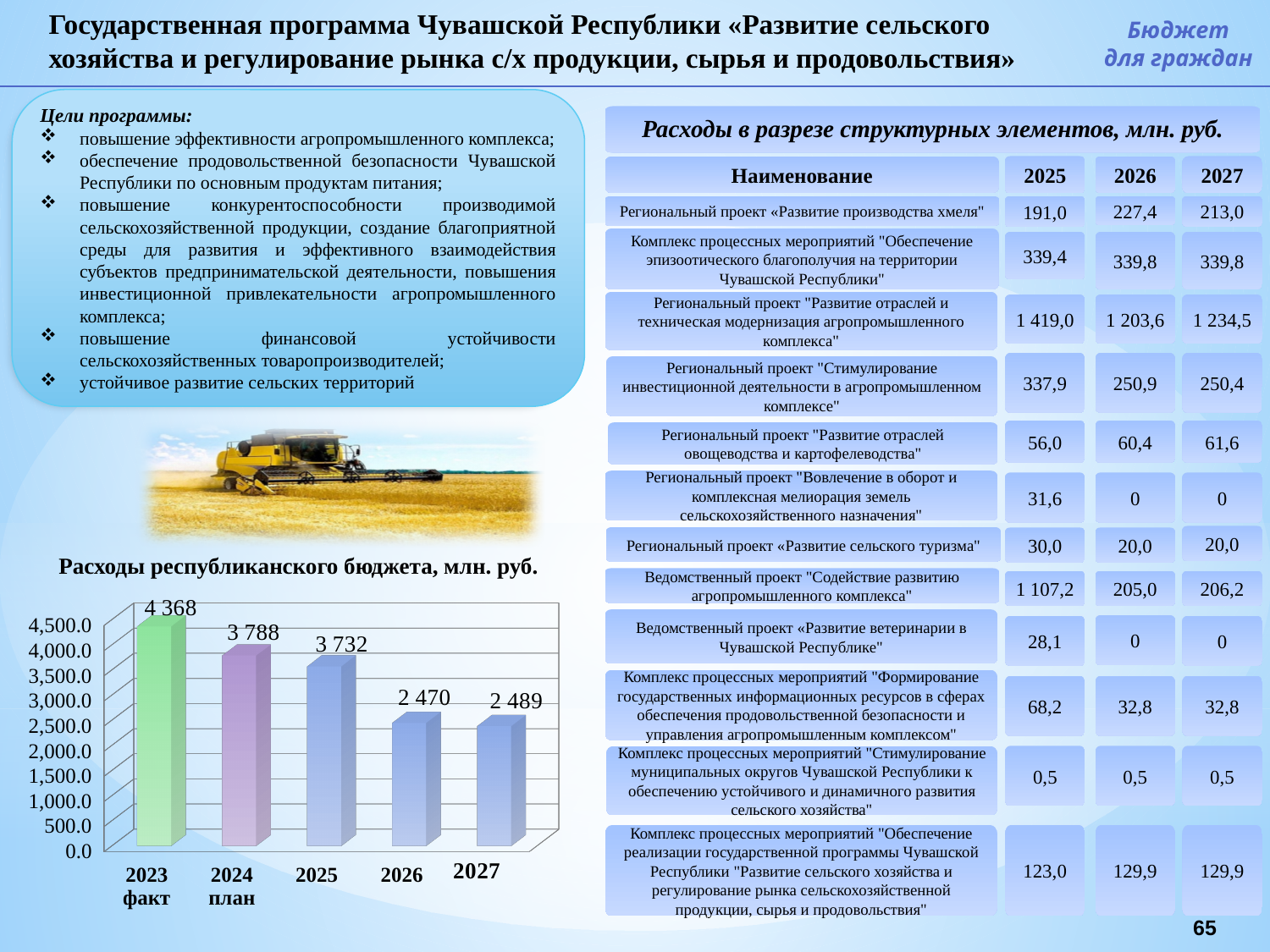
What is the value for 2024 план in the chart? 3 788 What is the value for 2023 факт in the chart "Расходы республиканского бюджета, млн. руб."? 4 368 Is the value for 2025 greater or less than 3,500.0? greater What kind of chart is shown on the slide? bar chart Which year has the highest value in the chart? 2023 факт What is the difference between the values for 2025 and 2026? 1 262 What is the value for 2027 in the chart? 2 489 How many bars are shown in the chart? 5 Which year has the lowest value in the chart? 2026 What is the difference between the values for 2023 факт and 2024 план? 580 What is the value for 2026 in the chart? 2 470 Which is larger, the value for 2024 план or the value for 2025? 2024 план